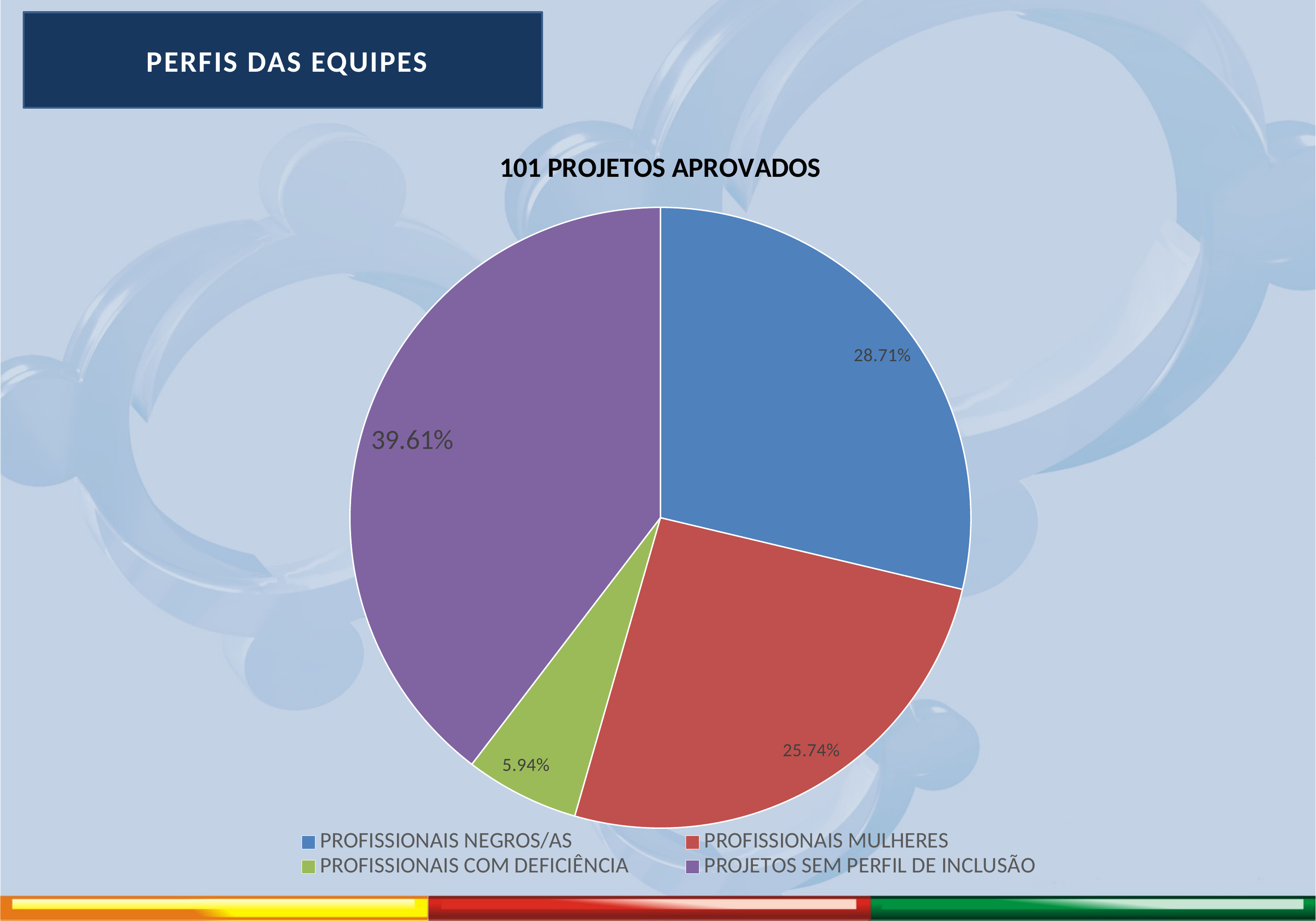
Which is larger, the slice for PROFISSIONAIS NEGROS/AS or the slice for PROFISSIONAIS MULHERES? PROFISSIONAIS NEGROS/AS What percentage is shown for PROFISSIONAIS COM DEFICIÊNCIA? 5.94% What is the title of the chart? 101 PROJETOS APROVADOS What percentage is shown for PROFISSIONAIS NEGROS/AS? 28.71% Which category has the largest slice of the pie? PROJETOS SEM PERFIL DE INCLUSÃO What is the difference in percentage points between PROJETOS SEM PERFIL DE INCLUSÃO and PROFISSIONAIS NEGROS/AS? 10.90% Which category has the smallest slice of the pie? PROFISSIONAIS COM DEFICIÊNCIA What percentage is shown for PROFISSIONAIS MULHERES? 25.74% How many slices does the pie chart have? 4 What type of chart is shown on the slide? pie chart What colour is the slice for PROFISSIONAIS COM DEFICIÊNCIA? green What percentage is shown for PROJETOS SEM PERFIL DE INCLUSÃO? 39.61%